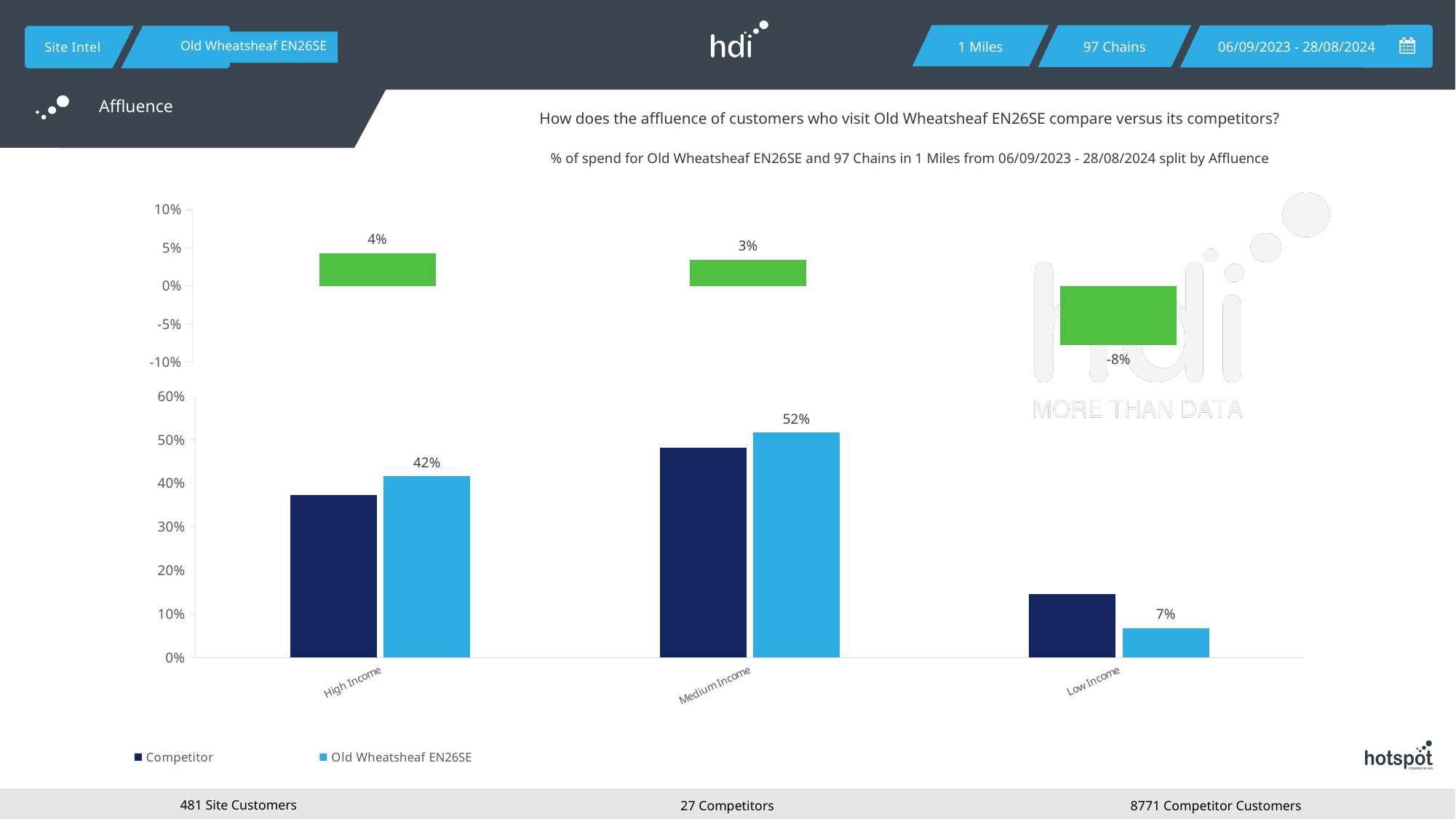
In the bottom chart, which category has the highest value for Old Wheatsheaf EN26SE? Medium Income In the bottom chart, what is the value for Old Wheatsheaf EN26SE in the Low Income category? 7% In the top chart, what is the value shown for the Low Income category? -8% In the bottom chart, what is the value for Old Wheatsheaf EN26SE in the Medium Income category? 52% In the bottom chart, what is the value for Old Wheatsheaf EN26SE in the High Income category? 42% In the top chart, which category has the lowest value? Low Income In the bottom chart, is the Competitor value for Medium Income greater or less than 40%? greater How many series does the legend of the bottom chart list? 2 In the bottom chart, which is larger for Low Income: the Competitor value or the Old Wheatsheaf EN26SE value? Competitor In the top chart, what is the value shown for the Medium Income category? 3% In the bottom chart, is the Competitor value for Low Income greater or less than 20%? less In the bottom chart, what is the difference between the Old Wheatsheaf EN26SE values for Medium Income and High Income? 10%